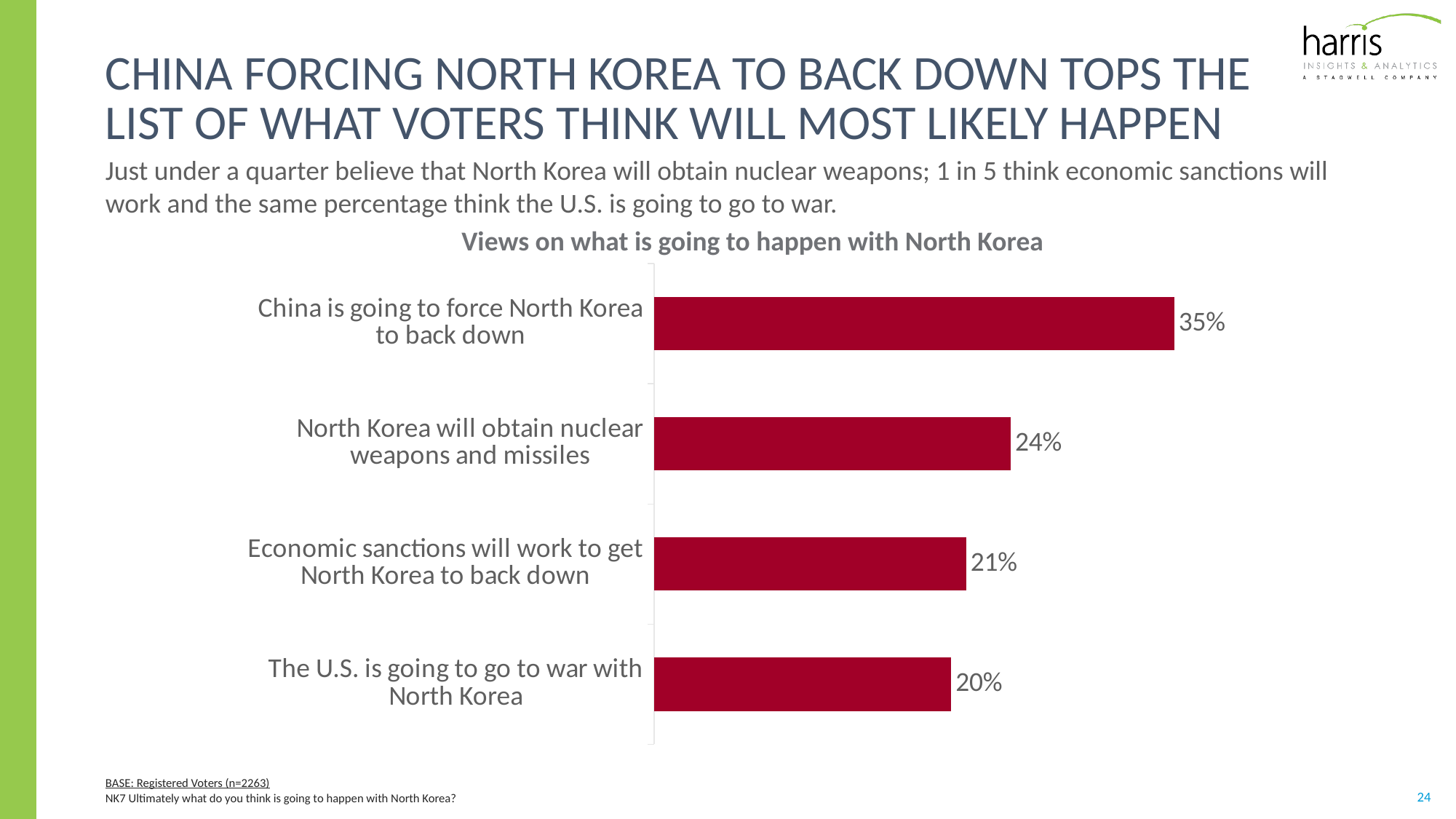
What is the title of the chart? Views on what is going to happen with North Korea What is the difference in percentage points between 'China is going to force North Korea to back down' and 'North Korea will obtain nuclear weapons and missiles'? 11 percentage points What percentage of voters think China is going to force North Korea to back down? 35% What value is shown for 'The U.S. is going to go to war with North Korea'? 20% Which is larger: the value for 'North Korea will obtain nuclear weapons and missiles' or the value for 'Economic sanctions will work to get North Korea to back down'? North Korea will obtain nuclear weapons and missiles What percentage think economic sanctions will work to get North Korea to back down? 21% Which category has the highest value in the chart? China is going to force North Korea to back down How many categories are shown in the chart? 4 What is the difference between the values for 'Economic sanctions will work to get North Korea to back down' and 'The U.S. is going to go to war with North Korea'? 1 percentage point What value is shown for 'North Korea will obtain nuclear weapons and missiles'? 24% Which category has the lowest value in the chart? The U.S. is going to go to war with North Korea What type of chart is shown on the slide? Bar chart